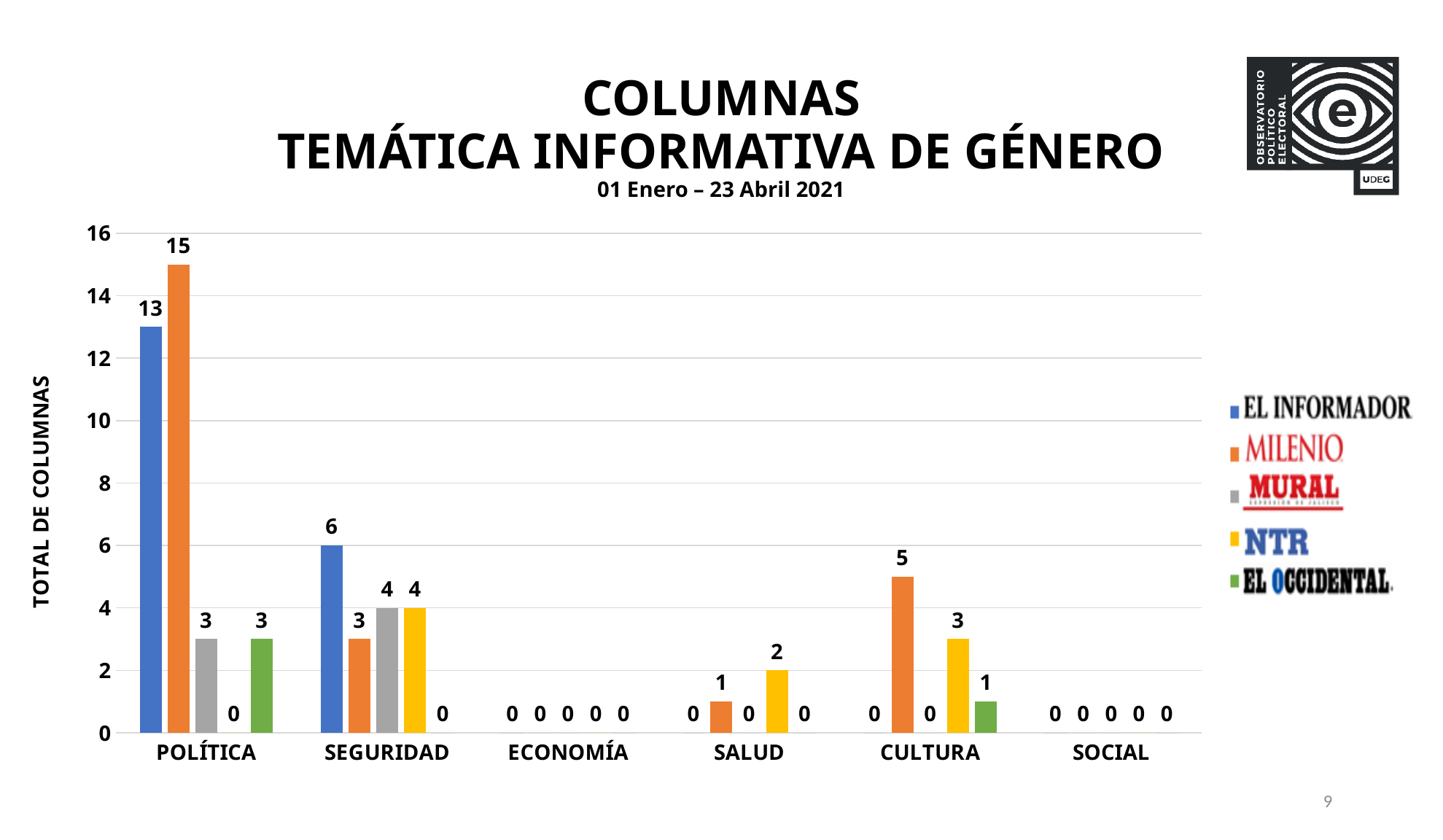
What is the difference between the Milenio and El Informador values in the POLÍTICA category? 2 Which category has the highest value for Milenio? POLÍTICA What is the total of all five series in the SEGURIDAD category? 17 What is the value for NTR in the SALUD category? 2 How many series does the legend list? 5 In the CULTURA category, which is larger: the value for Milenio or the value for NTR? Milenio What is the value for Milenio in the POLÍTICA category? 15 What type of chart is shown on the slide? bar chart What is the label of the y axis? TOTAL DE COLUMNAS What is the value for El Occidental in the CULTURA category? 1 How many categories are shown on the x axis? 6 What is the value for El Informador in the SEGURIDAD category? 6